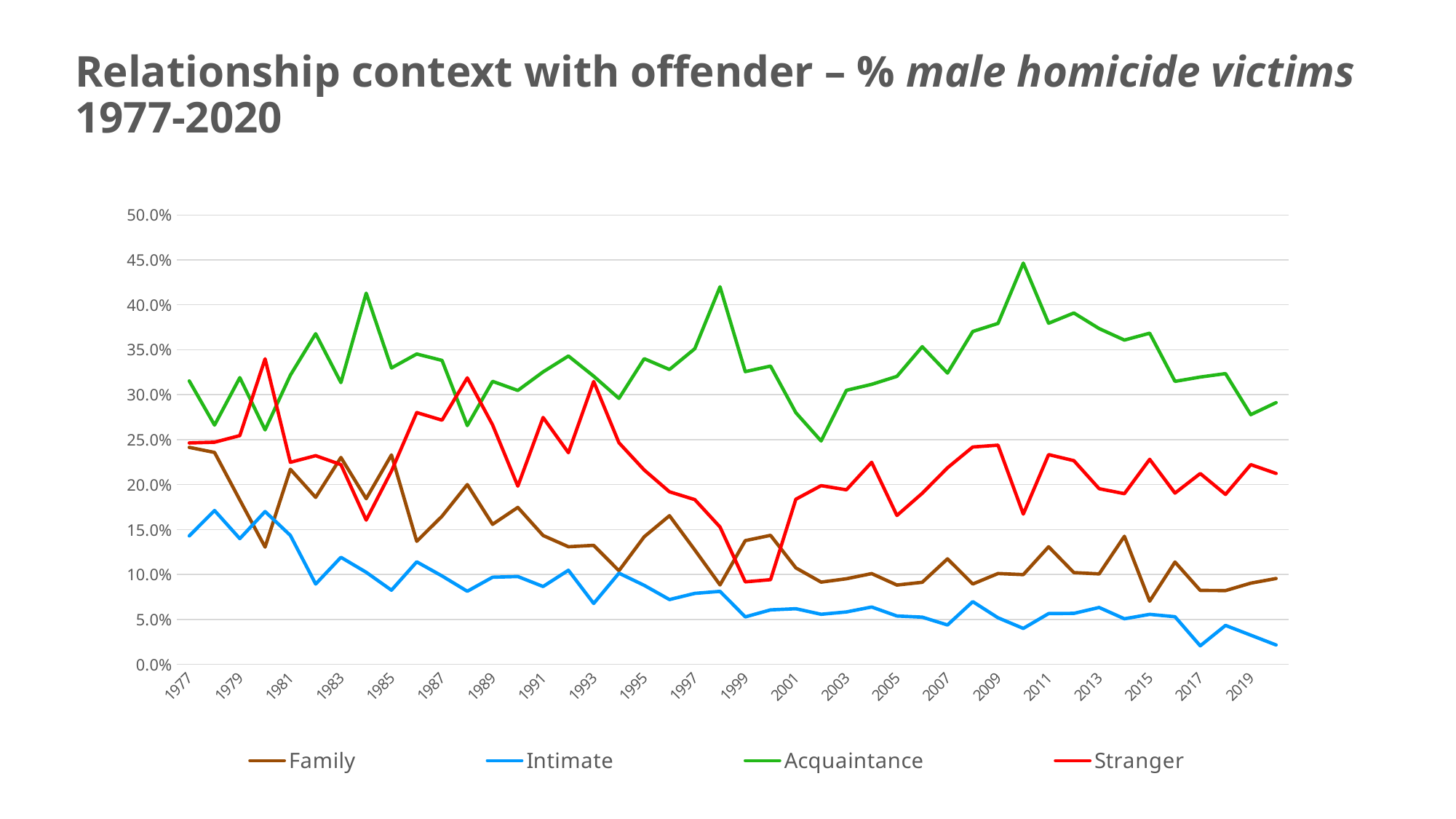
Is the value for Family in 2016 greater or less than 10.0%? greater Which series has the highest value in 2010? Acquaintance Is the value for Acquaintance in 2002 greater or less than 30.0%? less Is the value for Intimate in 2018 greater or less than 5.0%? less Which series has the lowest value in 2020? Intimate What range of years does the chart cover according to the title? 1977-2020 What kind of chart is shown on the slide? Line chart In 1977, which is larger, the value for Family or the value for Intimate? Family Which series are listed in the legend? Family, Intimate, Acquaintance, Stranger How many series does the legend list? 4